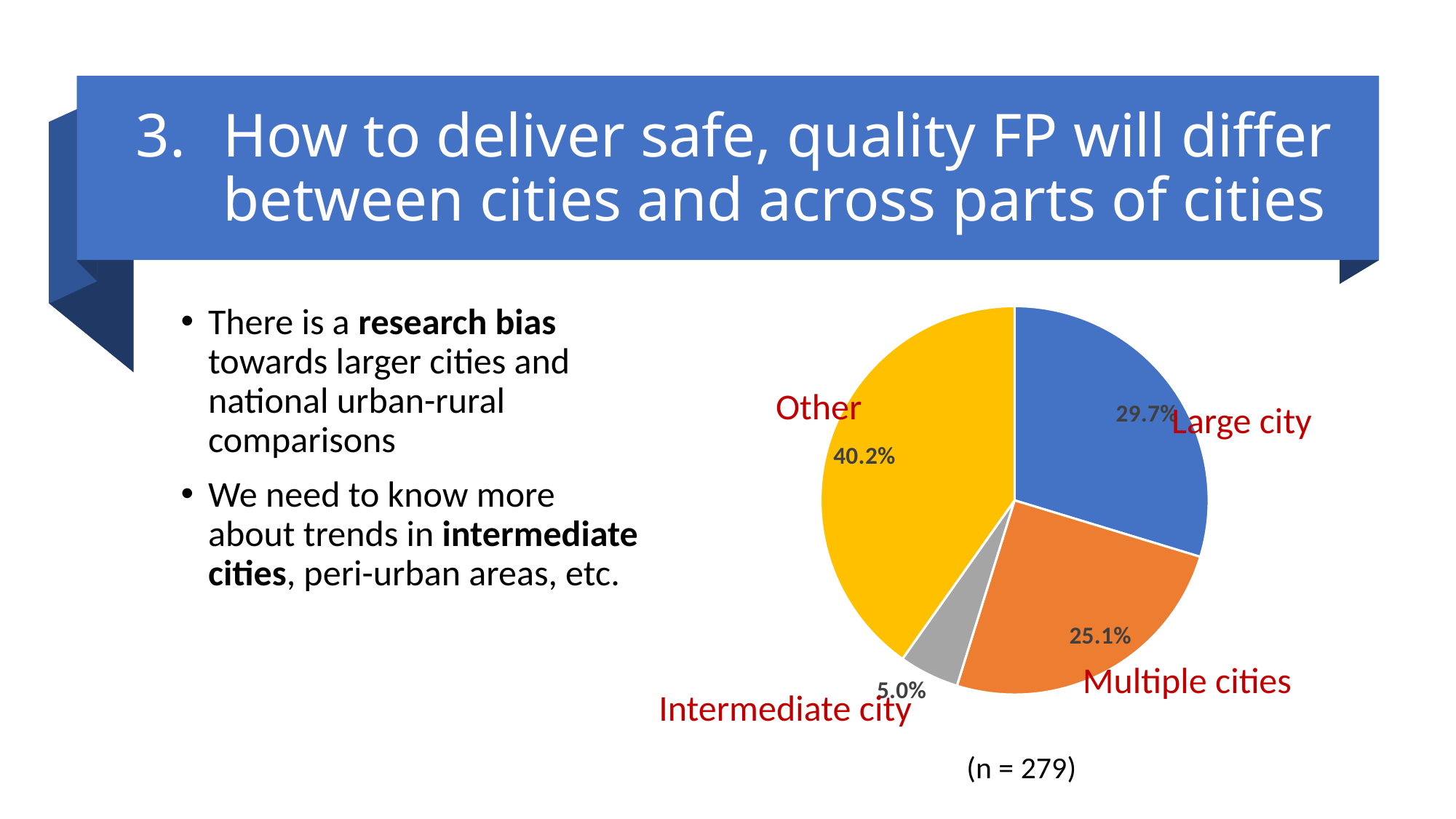
What is the difference in percentage points between the Multiple cities slice and the Intermediate city slice? 20.1 Which slice of the pie is the largest? Other What sample size (n) is shown below the pie chart? n = 279 Which is larger, the Large city slice or the Multiple cities slice? Large city What share of the pie does the Multiple cities slice represent? 25.1% How many slices does the pie chart have? 4 What share of the pie does the Other slice represent? 40.2% Which slice of the pie is the smallest? Intermediate city What share of the pie does the Intermediate city slice represent? 5.0% What is the difference in percentage points between the Other slice and the Large city slice? 10.5 What kind of chart is shown on the slide? pie chart What share of the pie does the Large city slice represent? 29.7%